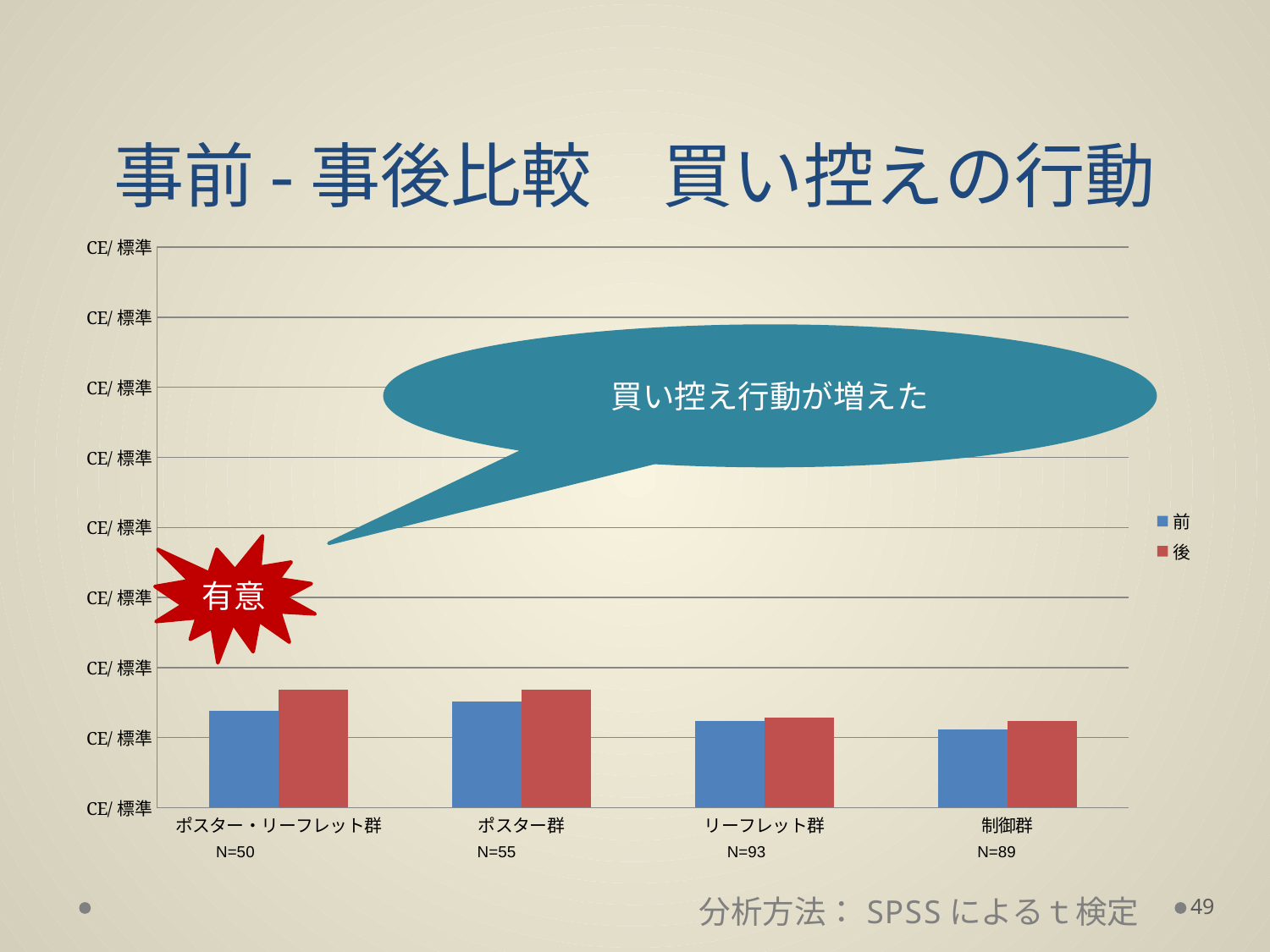
Which group has the lowest 前 bar? 制御群 For ポスター・リーフレット群, which bar is taller, 前 or 後? 後 What kind of chart is shown on the slide? bar chart Which is larger, the 後 bar for ポスター群 or the 後 bar for 制御群? ポスター群 What are the two series named in the chart's legend? 前, 後 How many series does the chart's legend list? 2 What sample size (N) is shown under リーフレット群 on the chart? N=93 For リーフレット群, which bar is taller, 前 or 後? 後 How many groups (categories) are shown along the x axis of the chart? 4